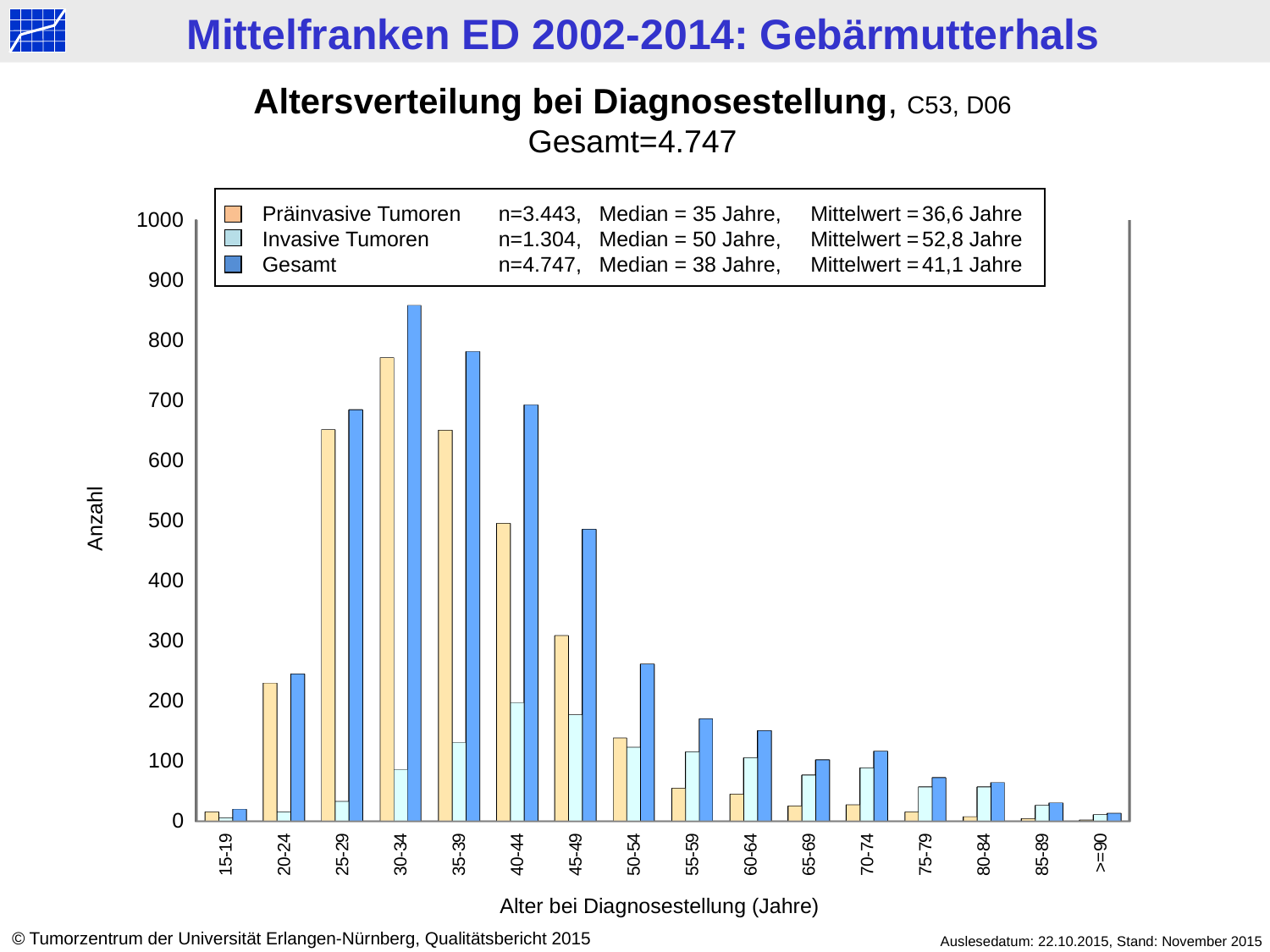
Is the Gesamt value for 50-54 greater or less than 200? greater Is the Gesamt value for 30-34 greater or less than 800? greater Which is larger for the Gesamt series: 35-39 or 40-44? 35-39 Which age category has the highest value for the Präinvasive Tumoren series? 30-34 How many series does the legend list? 3 Is the Invasive Tumoren value for 30-34 greater or less than 100? less What kind of chart is shown on the slide? bar chart Do the Gesamt values rise or fall from 30-34 to 50-54? fall According to the legend, what is the n for Invasive Tumoren? 1.304 Which age category has the highest value for the Gesamt series? 30-34 Which is larger for the 30-34 age group: Präinvasive Tumoren or Invasive Tumoren? Präinvasive Tumoren How many age categories are shown on the x axis? 16